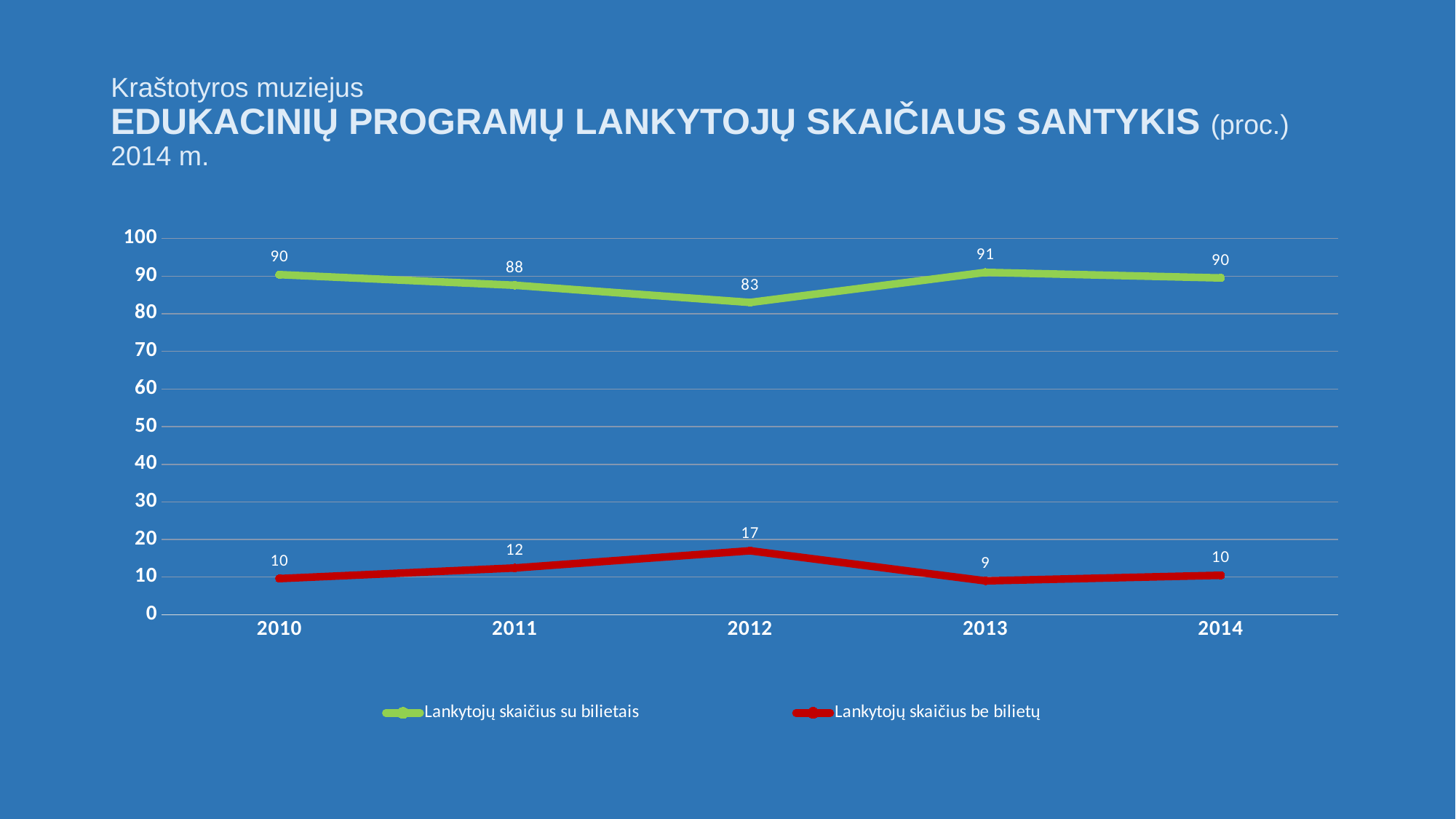
What is the difference between 'Lankytojų skaičius su bilietais' and 'Lankytojų skaičius be bilietų' in 2012? 66 Is the value for 'Lankytojų skaičius su bilietais' in 2011 greater or less than 80? greater How many series does the legend list? 2 Which colour is used for the 'Lankytojų skaičius be bilietų' series? red In which year is 'Lankytojų skaičius be bilietų' highest? 2012 Which is larger: 'Lankytojų skaičius be bilietų' in 2011 or in 2013? 2011 What is the value for 'Lankytojų skaičius su bilietais' in 2013? 91 In which year is 'Lankytojų skaičius su bilietais' lowest? 2012 How many years are shown on the x axis? 5 What kind of chart is shown on the slide? line chart What is the value for 'Lankytojų skaičius su bilietais' in 2012? 83 What is the value for 'Lankytojų skaičius be bilietų' in 2012? 17